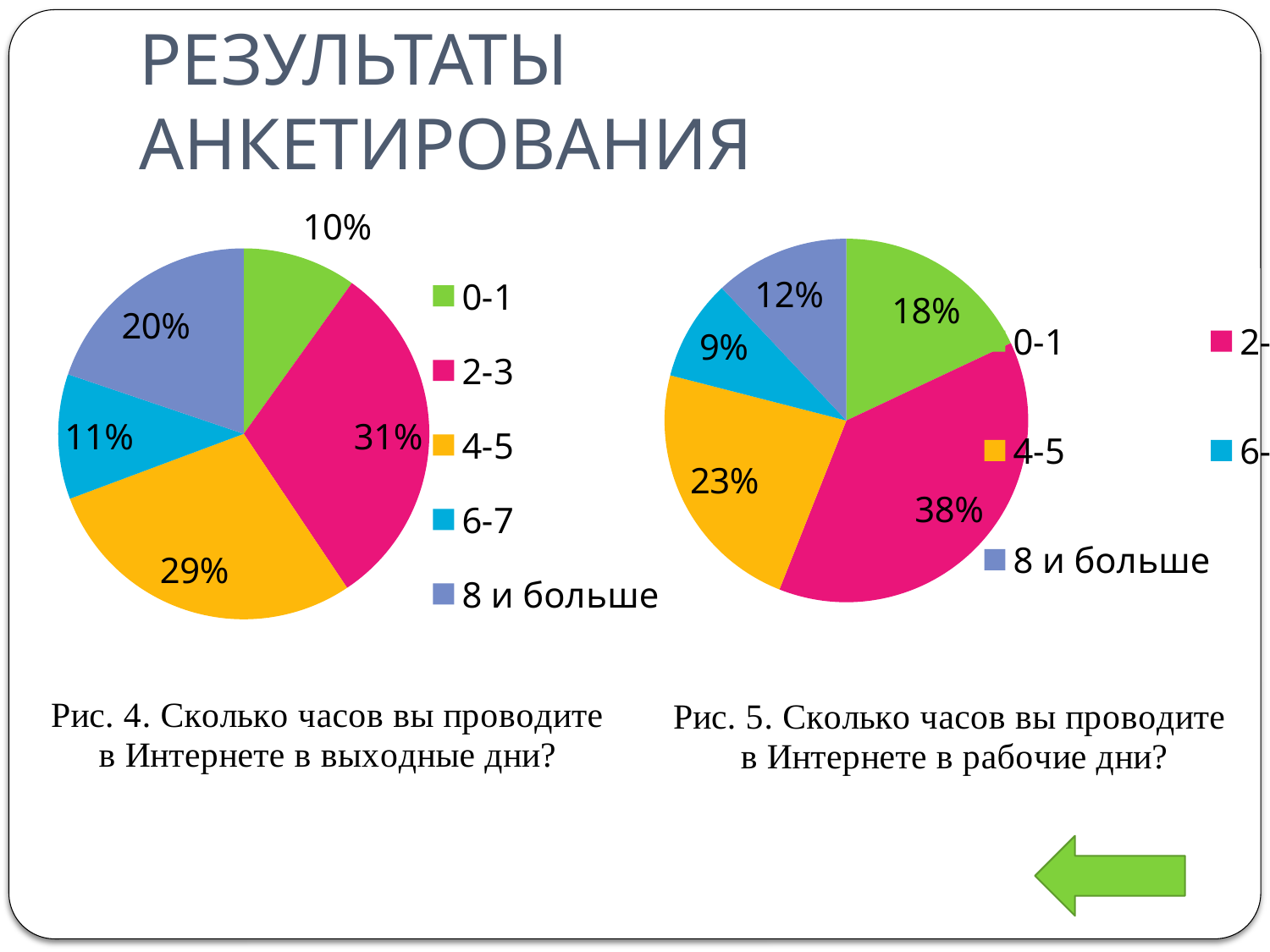
In the right pie chart (Рис. 5, workdays), what is the largest share shown? 38% In the left pie chart (Рис. 4, weekends), what share corresponds to the category 8 и больше? 20% In the left pie chart (Рис. 4, weekends), what share corresponds to the category 4-5? 29% In the left pie chart (Рис. 4, weekends), which category has the smallest share? 0-1 In the left pie chart (Рис. 4, weekends), what share corresponds to the category 0-1? 10% In the right pie chart (Рис. 5, workdays), what share corresponds to the category 0-1? 18% Which is larger: the share for 0-1 in the left chart (Рис. 4) or the share for 0-1 in the right chart (Рис. 5)? Right chart (Рис. 5) In the right pie chart (Рис. 5, workdays), what share corresponds to the category 8 и больше? 12% In the left pie chart (Рис. 4, weekends), what is the difference between the shares for 2-3 and 6-7? 20% In the right pie chart (Рис. 5, workdays), what share corresponds to the category 4-5? 23% What type of chart is used on this slide? Pie chart In the left pie chart (Рис. 4, weekends), which category has the largest share? 2-3